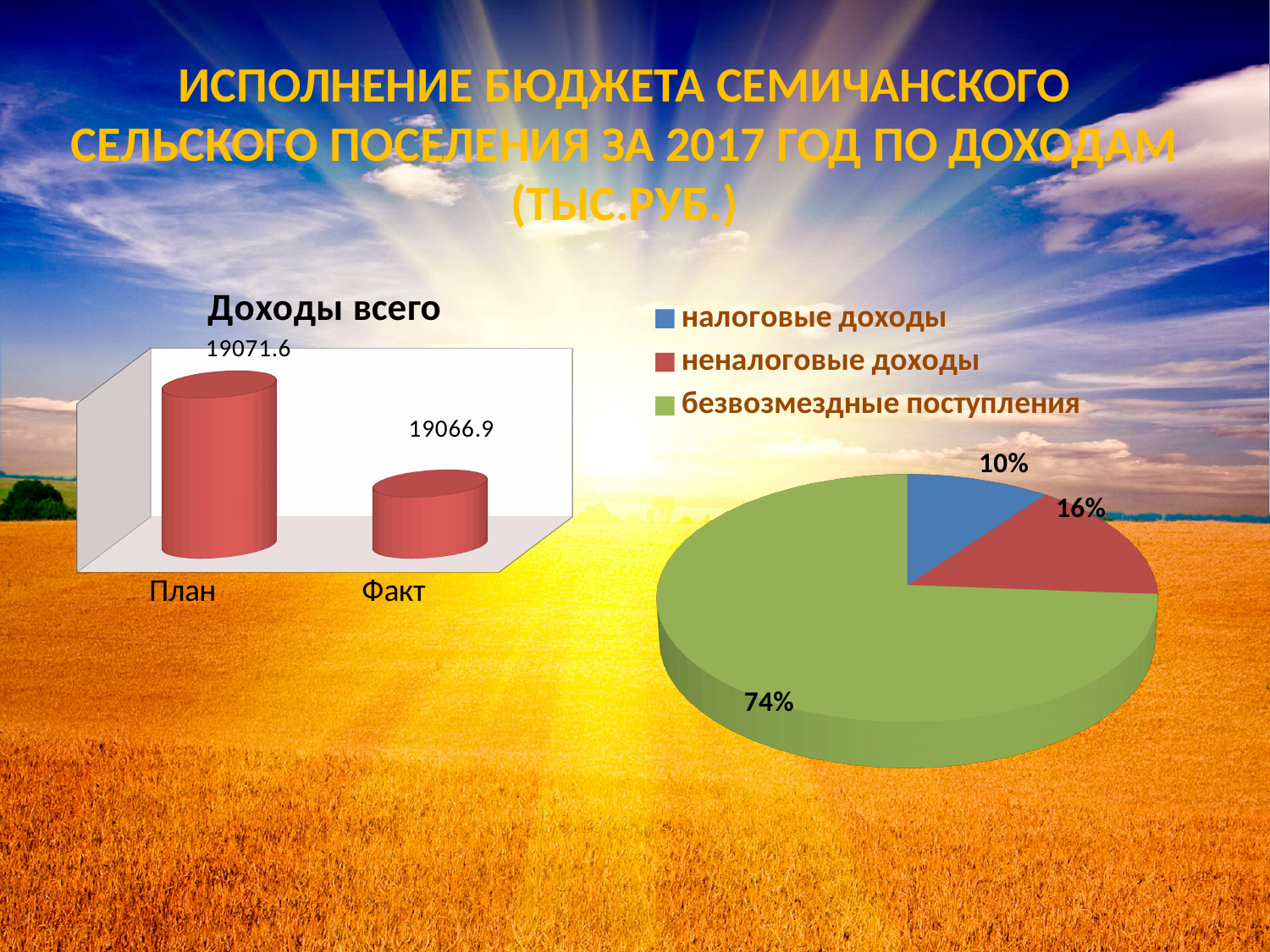
In the pie chart on the right, what share does неналоговые доходы have? 16% In the "Доходы всего" chart, which category has the higher value, План or Факт? План In the pie chart on the right, what share does налоговые доходы have? 10% What kind of chart is the "Доходы всего" chart on the left? Bar chart In the "Доходы всего" chart, what is the value for Факт? 19066.9 How many entries does the legend of the pie chart on the right list? 3 In the "Доходы всего" chart, what is the difference between the План and Факт values? 4.7 In the "Доходы всего" chart, what is the value for План? 19071.6 In the pie chart on the right, which category has the largest slice? безвозмездные поступления How many categories are shown in the "Доходы всего" chart? 2 In the pie chart on the right, what share does безвозмездные поступления have? 74% In the pie chart on the right, which category has the smallest slice? налоговые доходы